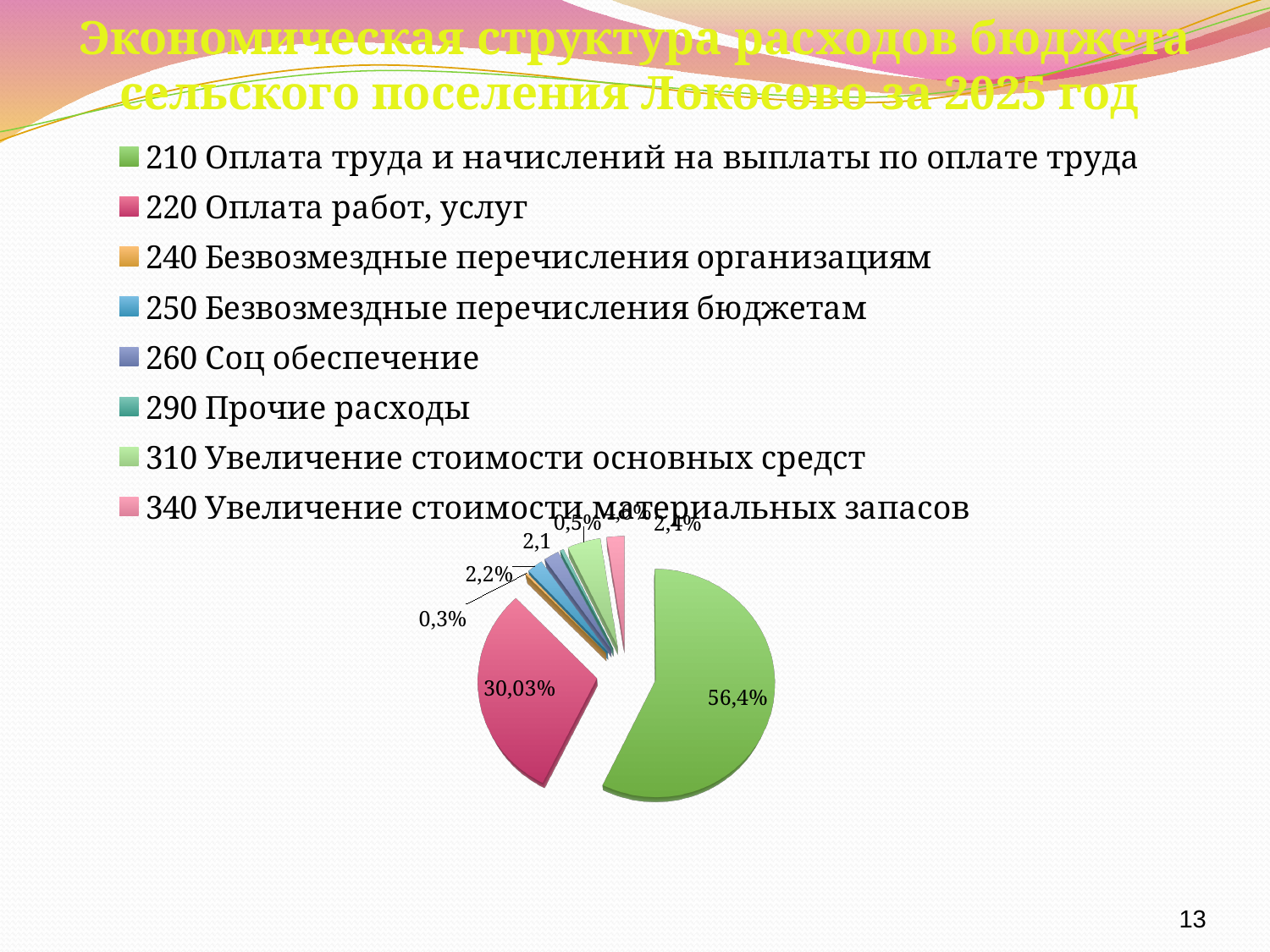
What share is labelled for 340 Увеличение стоимости материальных запасов? 2,4% What share is labelled for 250 Безвозмездные перечисления бюджетам? 2,2% What share of the pie is labelled for 220 Оплата работ, услуг? 30,03% Which category has the largest slice of the pie? 210 Оплата труда и начислений на выплаты по оплате труда How many categories does the legend of the pie chart list? 8 What share is labelled for 240 Безвозмездные перечисления организациям? 0,3% By how many percentage points does the slice for 210 Оплата труда exceed the slice for 220 Оплата работ, услуг? 26,37 What kind of chart is shown on the slide? pie chart Which is larger: the slice for 210 Оплата труда или 220 Оплата работ, услуг? 210 Оплата труда и начислений на выплаты по оплате труда What is the title of the slide with the pie chart? Экономическая структура расходов бюджета сельского поселения Локосово за 2025 год Which category has the smallest slice of the pie? 240 Безвозмездные перечисления организациям What share of the pie is labelled for 210 Оплата труда и начислений на выплаты по оплате труда? 56,4%